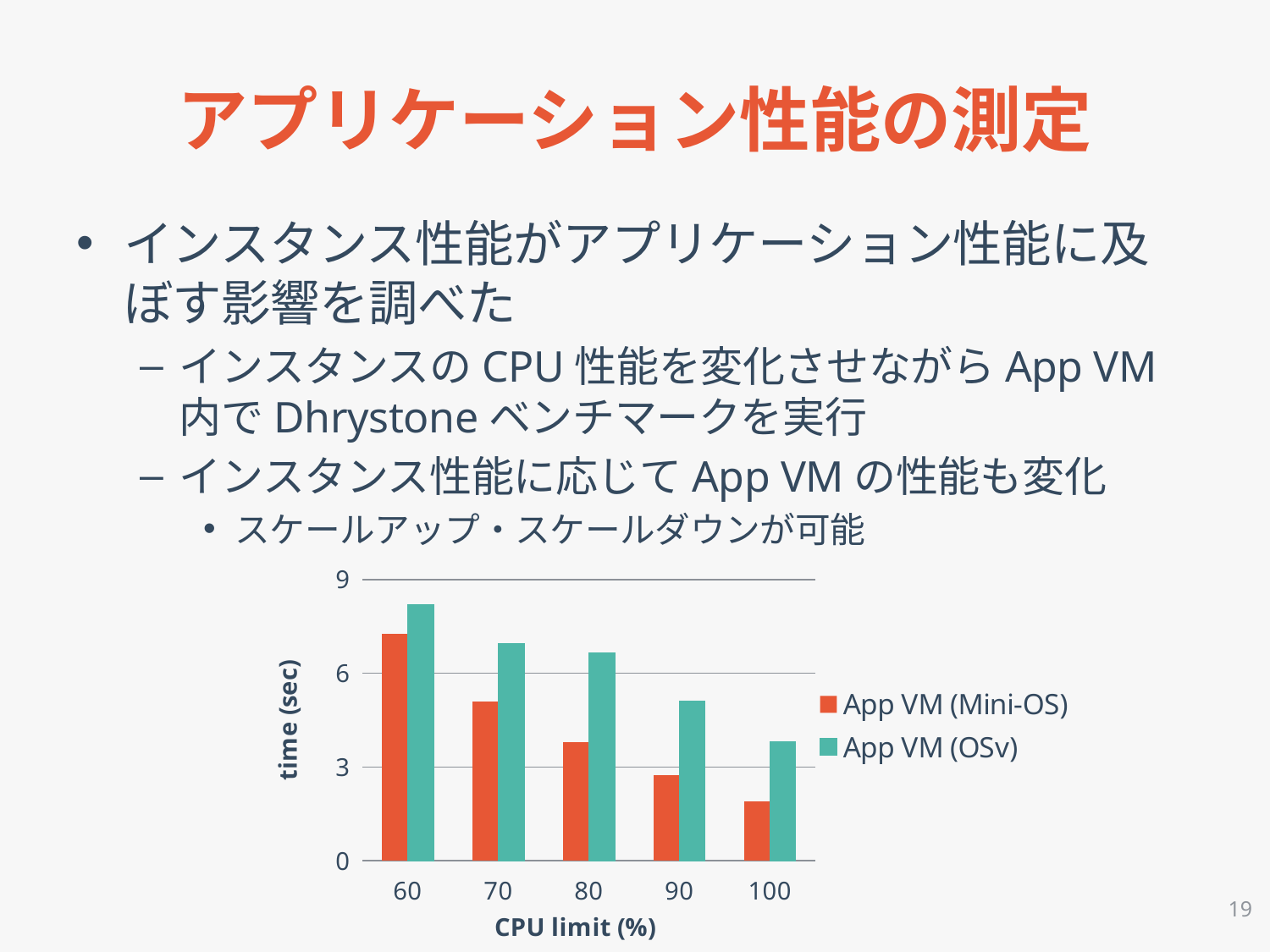
Do the App VM (Mini-OS) values rise or fall as the CPU limit increases from 60 to 100? fall At which CPU limit is the App VM (OSv) time highest? 60 At which CPU limit is the App VM (Mini-OS) time lowest? 100 Is the App VM (Mini-OS) value at a CPU limit of 60 greater or less than 6? greater What is the label of the x axis? CPU limit (%) How many CPU limit categories are shown on the x axis? 5 Is the App VM (Mini-OS) value at a CPU limit of 100 greater or less than 3? less How many series does the legend list? 2 Is the App VM (OSv) value at a CPU limit of 100 greater or less than 6? less What is the label of the y axis? time (sec) What kind of chart is shown on the slide? bar chart At a CPU limit of 80, which series has the larger time, App VM (Mini-OS) or App VM (OSv)? App VM (OSv)